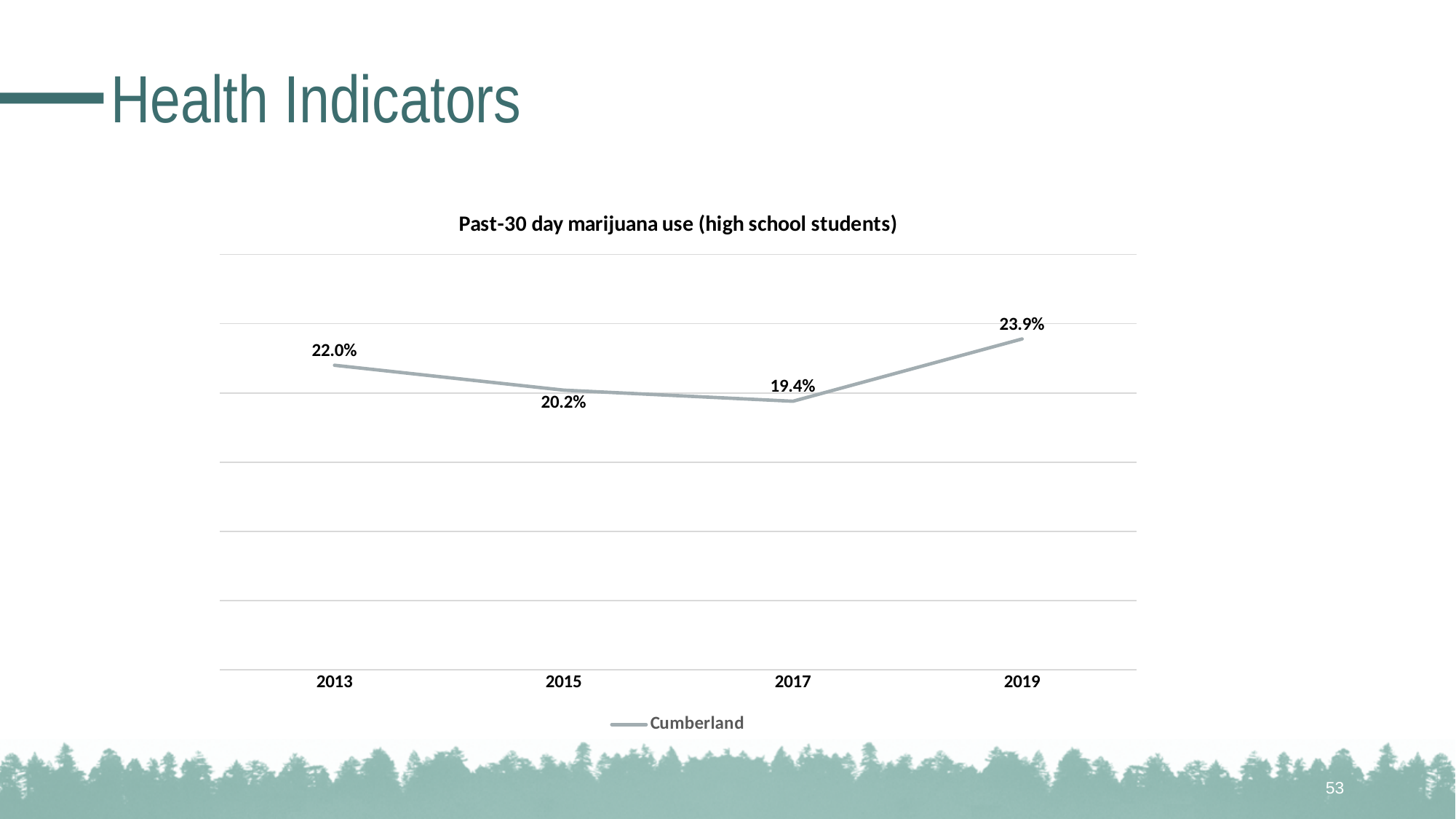
What is the value for 2019 in the Past-30 day marijuana use chart? 23.9% Which year has the lowest value in the Past-30 day marijuana use chart? 2017 How many series does the legend of the Past-30 day marijuana use chart list? 1 What kind of chart is the Past-30 day marijuana use chart? Line chart What is the value for 2013 in the Past-30 day marijuana use chart? 22.0% Which is larger in the Past-30 day marijuana use chart, the value for 2013 or the value for 2015? 2013 How many years are plotted in the Past-30 day marijuana use chart? 4 What is the value for 2017 in the Past-30 day marijuana use chart? 19.4% What is the difference between the 2013 and 2015 values in the Past-30 day marijuana use chart? 1.8% Which year has the highest value in the Past-30 day marijuana use chart? 2019 What is the difference between the 2019 and 2017 values in the Past-30 day marijuana use chart? 4.5% What series name is shown in the legend of the Past-30 day marijuana use chart? Cumberland